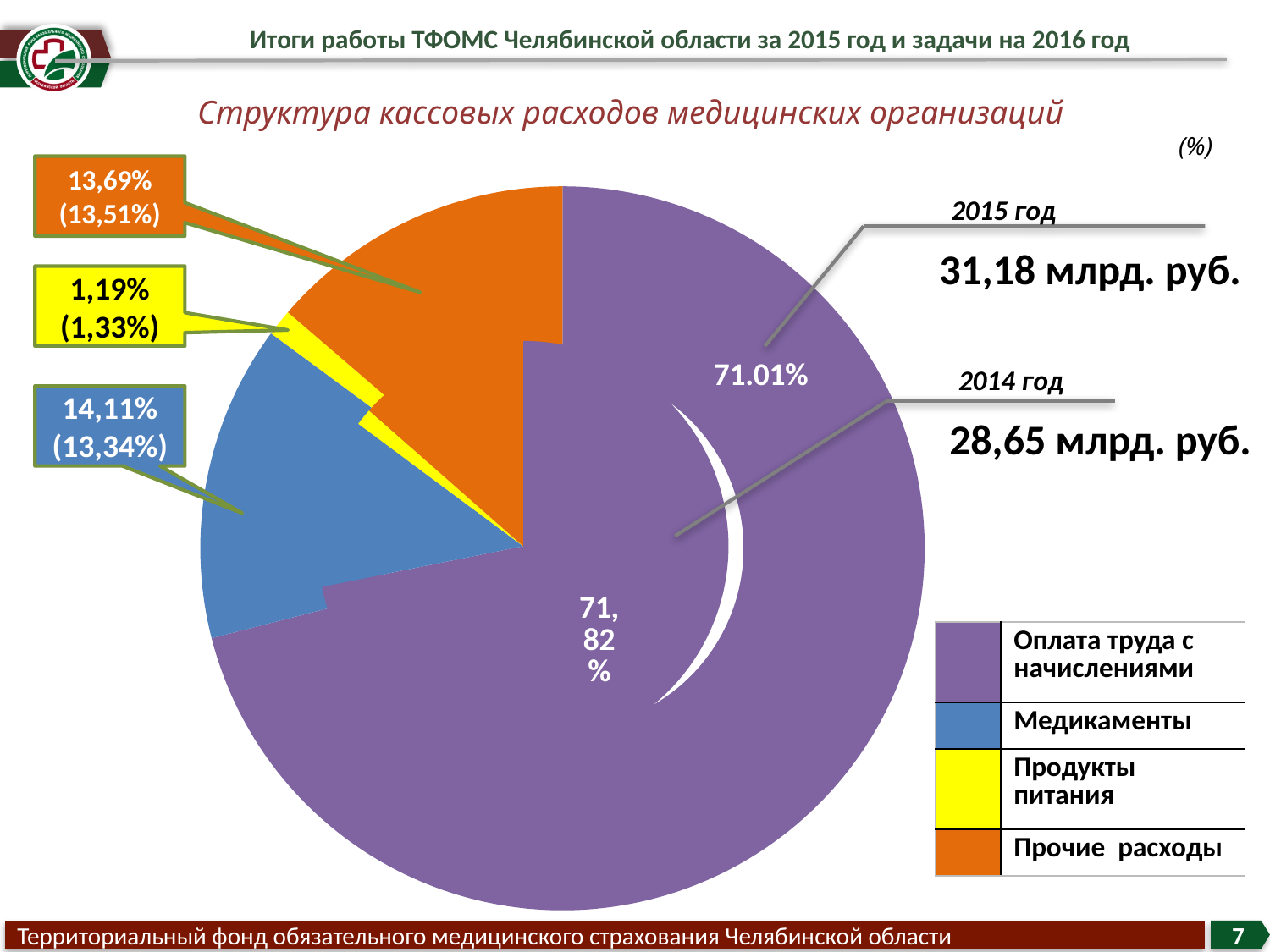
How many categories does the legend of the pie chart list? 4 What total amount in billions of rubles is shown for 2015 год? 31,18 млрд. руб. What colour represents 'Продукты питания' in the legend? yellow What is the 2015 share for 'Медикаменты' shown in the callout? 14,11% Which has the larger 2015 share: 'Медикаменты' or 'Прочие расходы'? Медикаменты Which category has the smallest share of the pie chart? Продукты питания What is the 2014 share for 'Медикаменты' shown in parentheses in the callout? 13,34% What is the 2015 share for 'Оплата труда с начислениями' in the pie chart? 71.01% What is the 2015 share for 'Продукты питания' shown in the callout? 1,19% Which category has the largest share of the pie chart? Оплата труда с начислениями What is the 2014 share for 'Прочие расходы' shown in parentheses in the callout? 13,51% What kind of chart is shown on the slide? pie chart